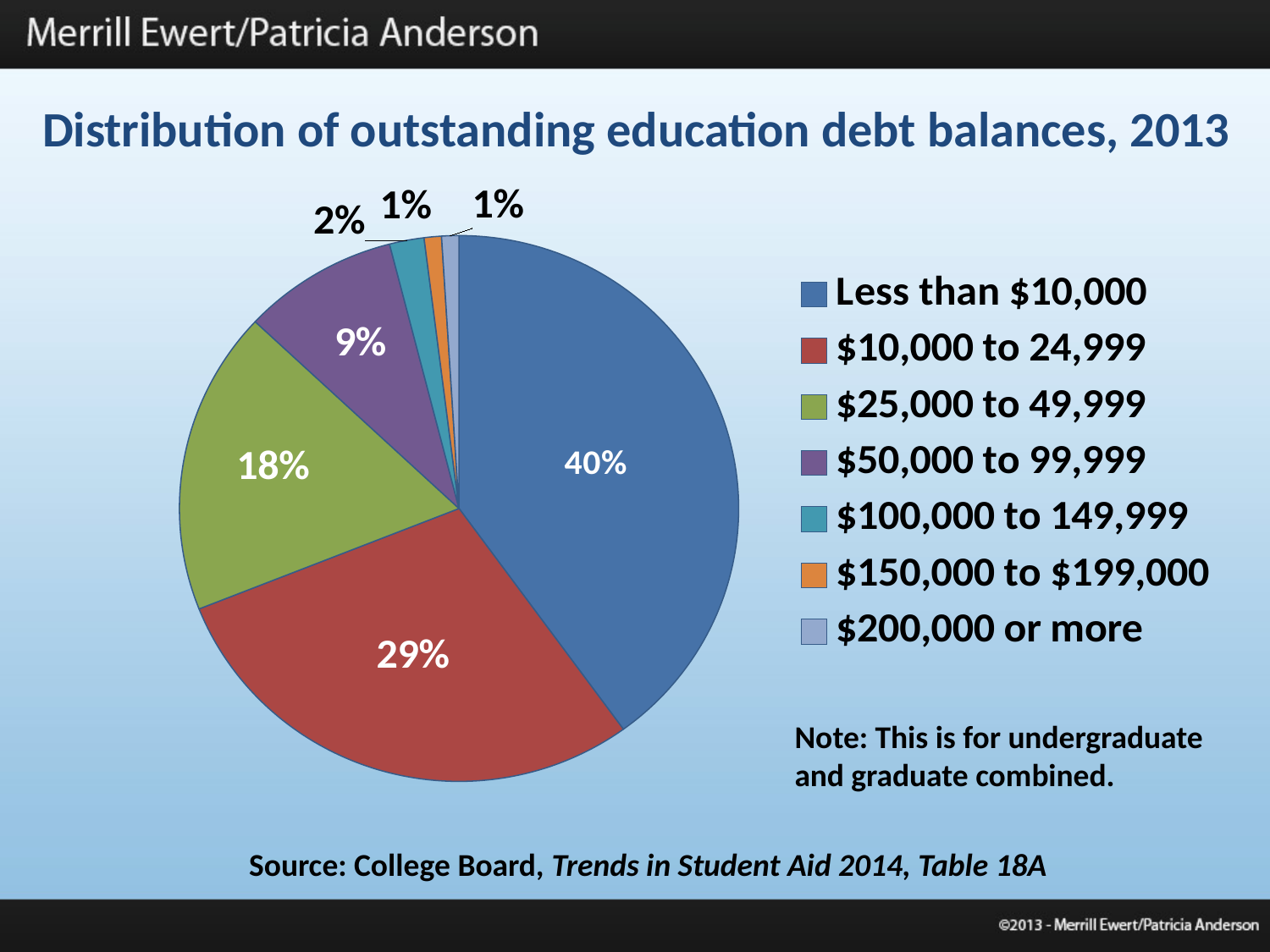
What share of outstanding education debt balances is for 'Less than $10,000'? 40% How many categories does the legend list? 7 Which debt balance category has the largest share of the pie? Less than $10,000 What percentage is shown for the '$25,000 to 49,999' slice? 18% Which is larger: the '$25,000 to 49,999' slice or the '$50,000 to 99,999' slice? $25,000 to 49,999 What percentage is shown for the '$100,000 to 149,999' slice? 2% What percentage is shown for the '$10,000 to 24,999' slice? 29% What colour is the slice for '$10,000 to 24,999'? Red What is the title of the chart? Distribution of outstanding education debt balances, 2013 What is the difference in percentage points between the 'Less than $10,000' slice and the '$10,000 to 24,999' slice? 11 What type of chart is shown on the slide? Pie chart What percentage is shown for the '$50,000 to 99,999' slice? 9%